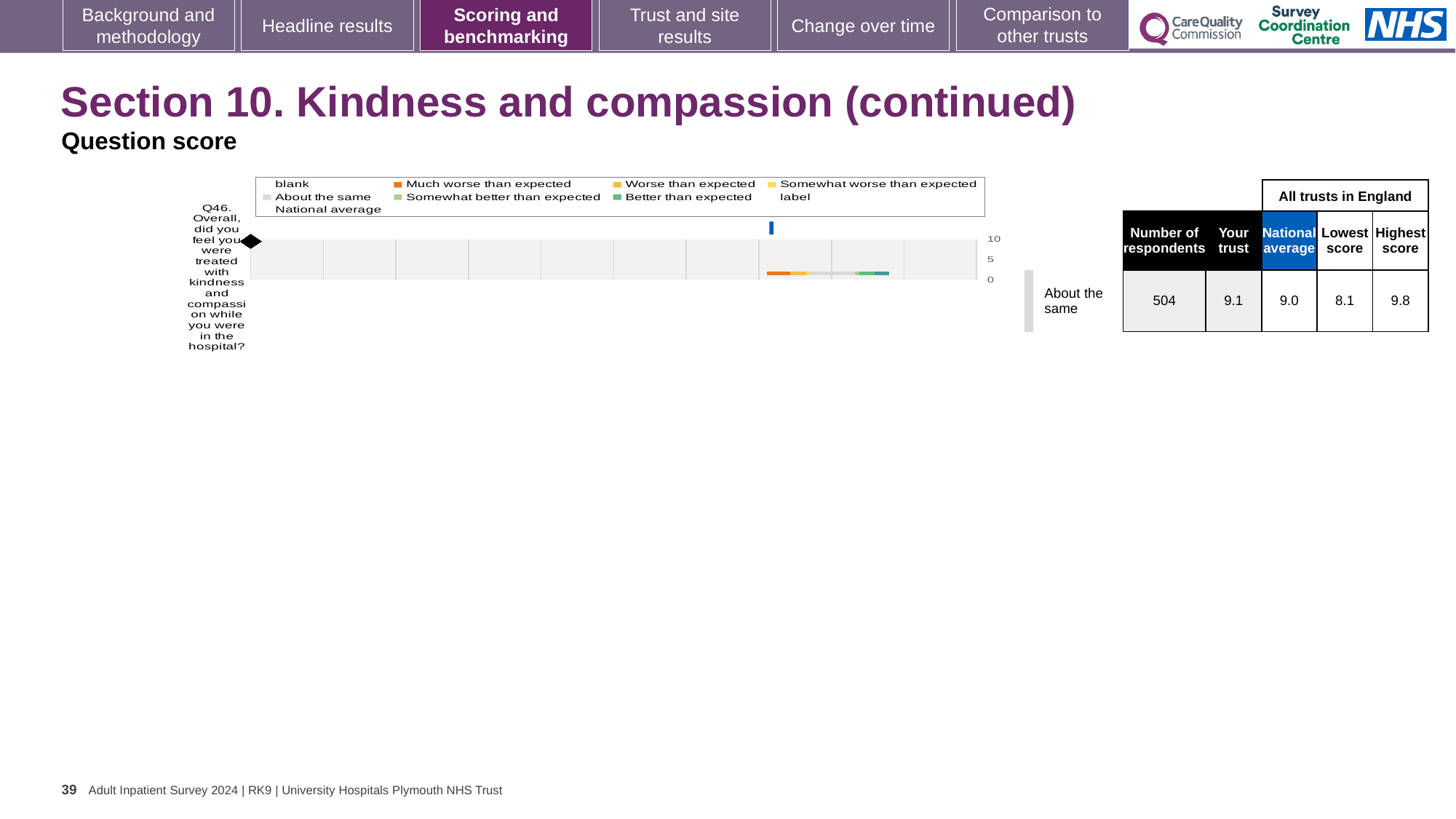
For Q46, what is the difference between the highest score and the lowest score among all trusts in England? 1.7 According to the table beside the chart, how many respondents answered Q46? 504 For Q46, which is larger: the 'Your trust' score or the national average? Your trust How many survey questions are plotted in the chart on this slide? 1 What kind of chart is shown for Q46 on this slide? bar chart According to the table beside the chart, what is the national average score for Q46? 9.0 What is the highest value shown on the chart's score axis? 10 Which survey question is plotted in the chart on this slide? Q46. Overall, did you feel you were treated with kindness and compassion while you were in the hospital? According to the table beside the chart, what is the highest score among all trusts in England for Q46? 9.8 What benchmark category is the trust's Q46 score labelled as next to the chart? About the same According to the table beside the chart, what is the lowest score among all trusts in England for Q46? 8.1 According to the table beside the chart, what is the 'Your trust' score for Q46? 9.1